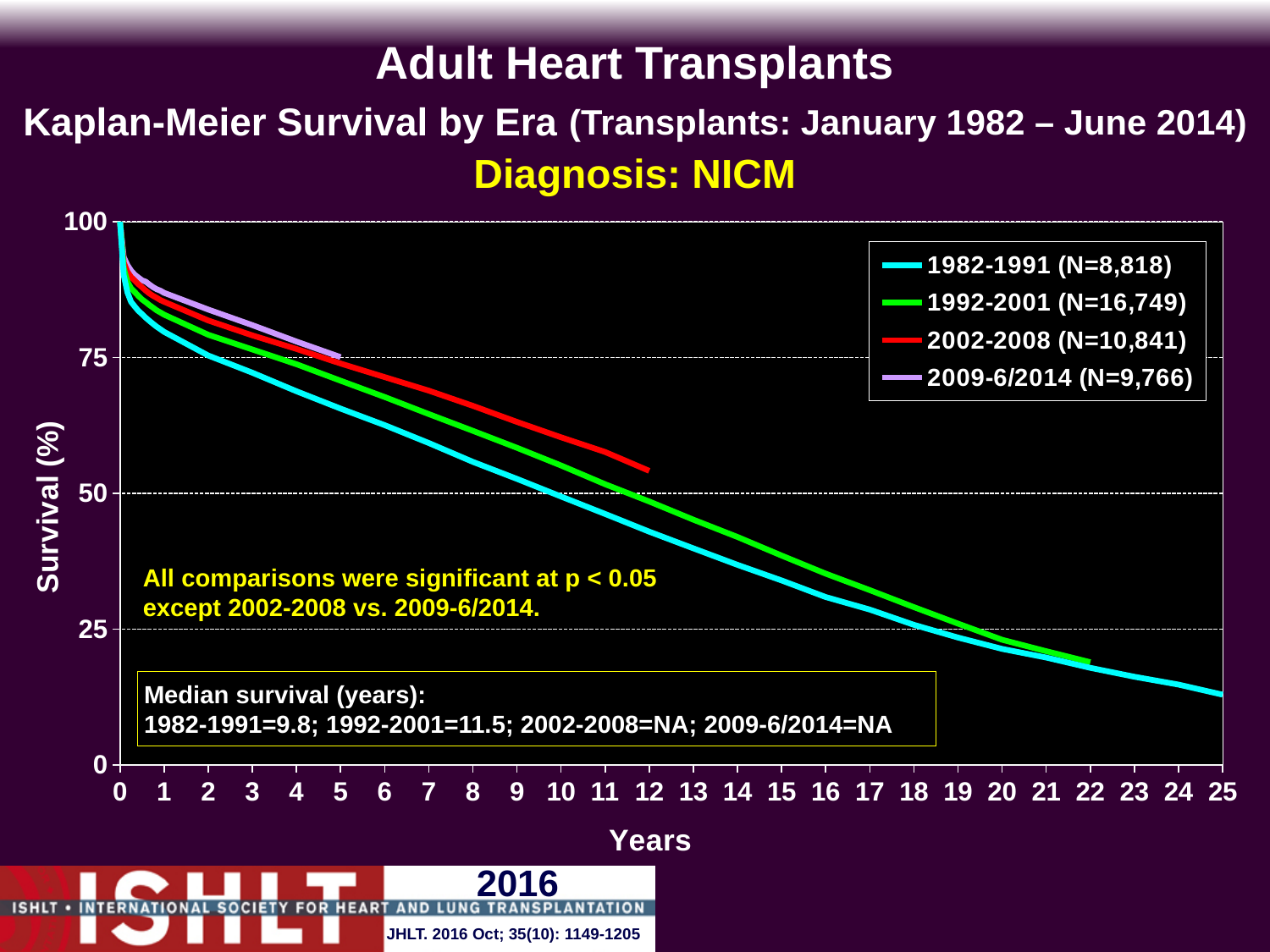
Is the survival for the 1982-1991 era at 15 years greater or less than 50%? less What is the median survival listed for the 2002-2008 era? NA Do the survival curves rise or fall as years increase? fall At 5 years, which era has higher survival: 1982-1991 or 2002-2008? 2002-2008 How many series (eras) does the legend list? 4 What kind of chart is shown on the slide? line chart What is the difference in median survival (years) between the 1992-2001 and 1982-1991 eras? 1.7 Which era has the lowest survival at 5 years? 1982-1991 Is the survival for the 1982-1991 era at 5 years greater or less than 50%? greater Is the survival for the 2002-2008 era at 10 years greater or less than 50%? greater What is the median survival in years for the 1992-2001 era? 11.5 What is the median survival in years for the 1982-1991 era? 9.8